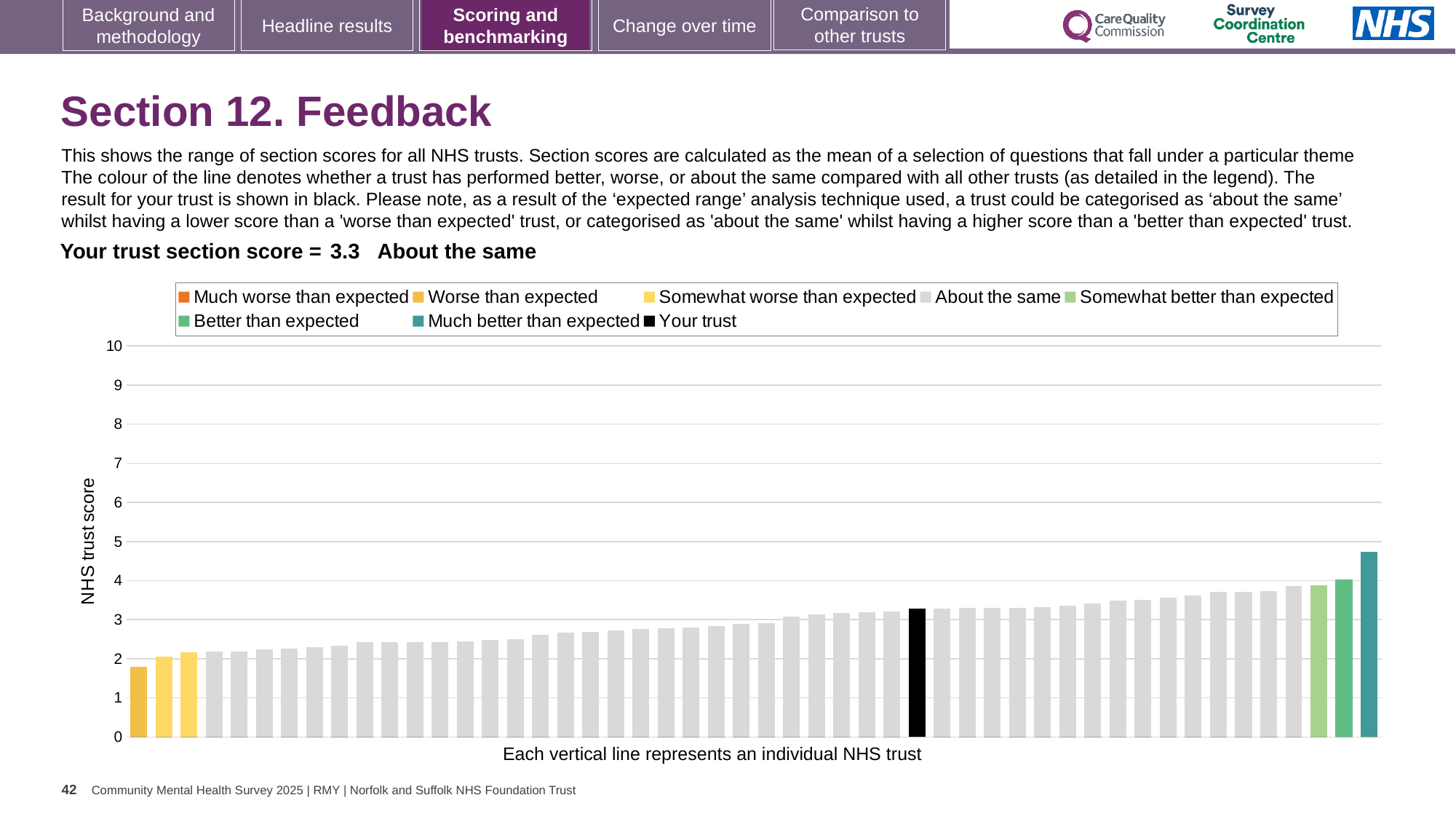
Which legend category does the tallest bar belong to? Much better than expected How many entries does the chart legend list? 8 Do the bar values rise or fall moving from left to right along the x axis? rise Is the value of the black 'Your trust' bar greater or less than 3? greater What type of chart is shown on the slide? bar chart What is the label on the vertical axis of the chart? NHS trust score What is the section score for your trust shown on the slide? 3.3 Is the value of the shortest bar (the leftmost bar) greater or less than 2? less Is the value of the tallest bar (the rightmost, teal bar) greater or less than 4? greater How many bars are coloured as 'Much better than expected' (teal)? 1 Which is taller, the leftmost bar or the rightmost bar? the rightmost bar What colour is the bar representing your trust? black